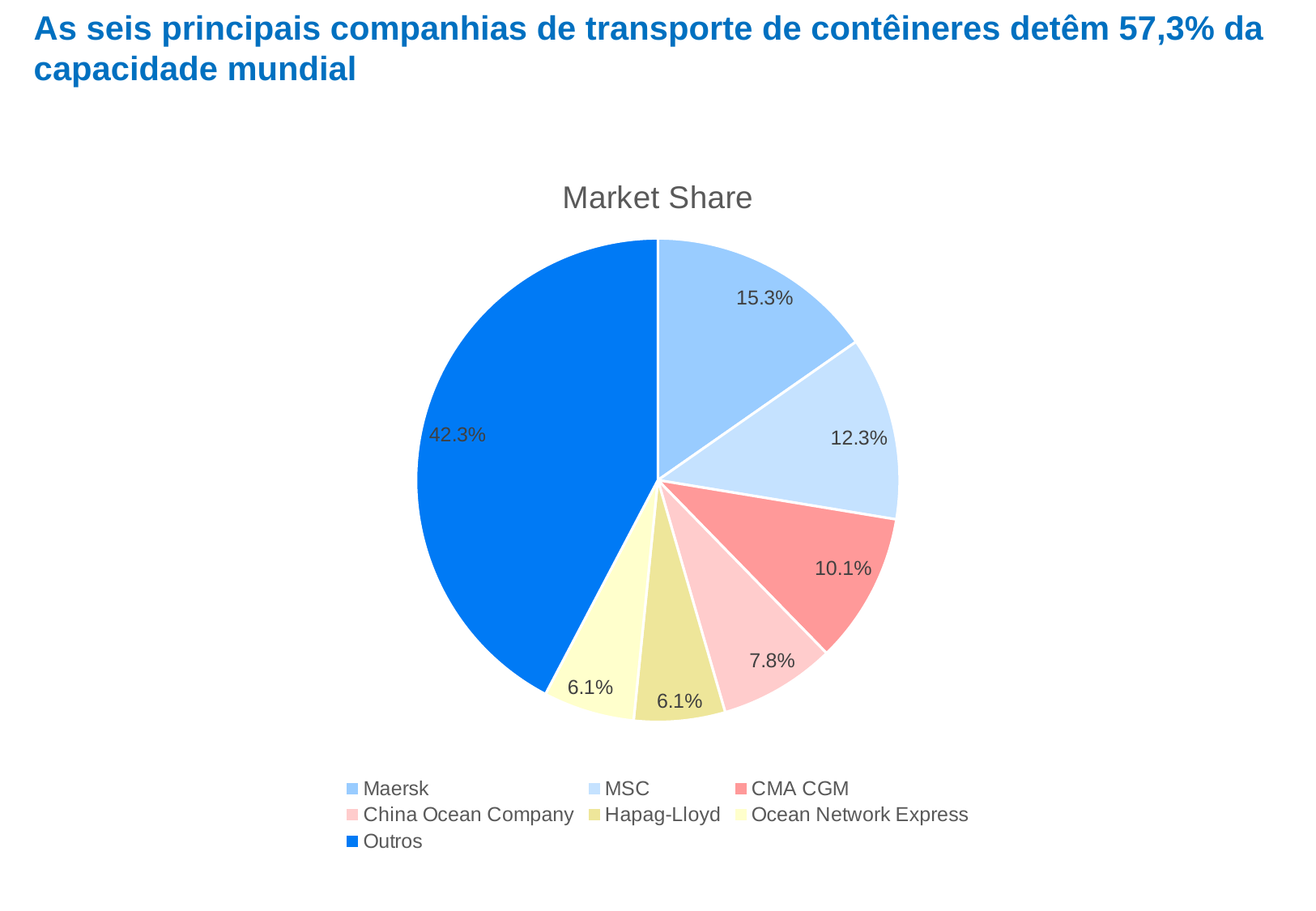
Which has a larger market share, CMA CGM or China Ocean Company? CMA CGM What is the combined market share of Hapag-Lloyd and Ocean Network Express? 12.2% What is the market share of CMA CGM? 10.1% What is the title of the chart? Market Share What is the market share of MSC? 12.3% What is the market share of China Ocean Company? 7.8% Which slice of the pie is the largest? Outros What is the market share of Maersk? 15.3% What type of chart is shown on the slide? pie chart What is the market share of Hapag-Lloyd? 6.1% What is the difference between the market share of Maersk and MSC? 3.0% How many slices does the pie chart have? 7